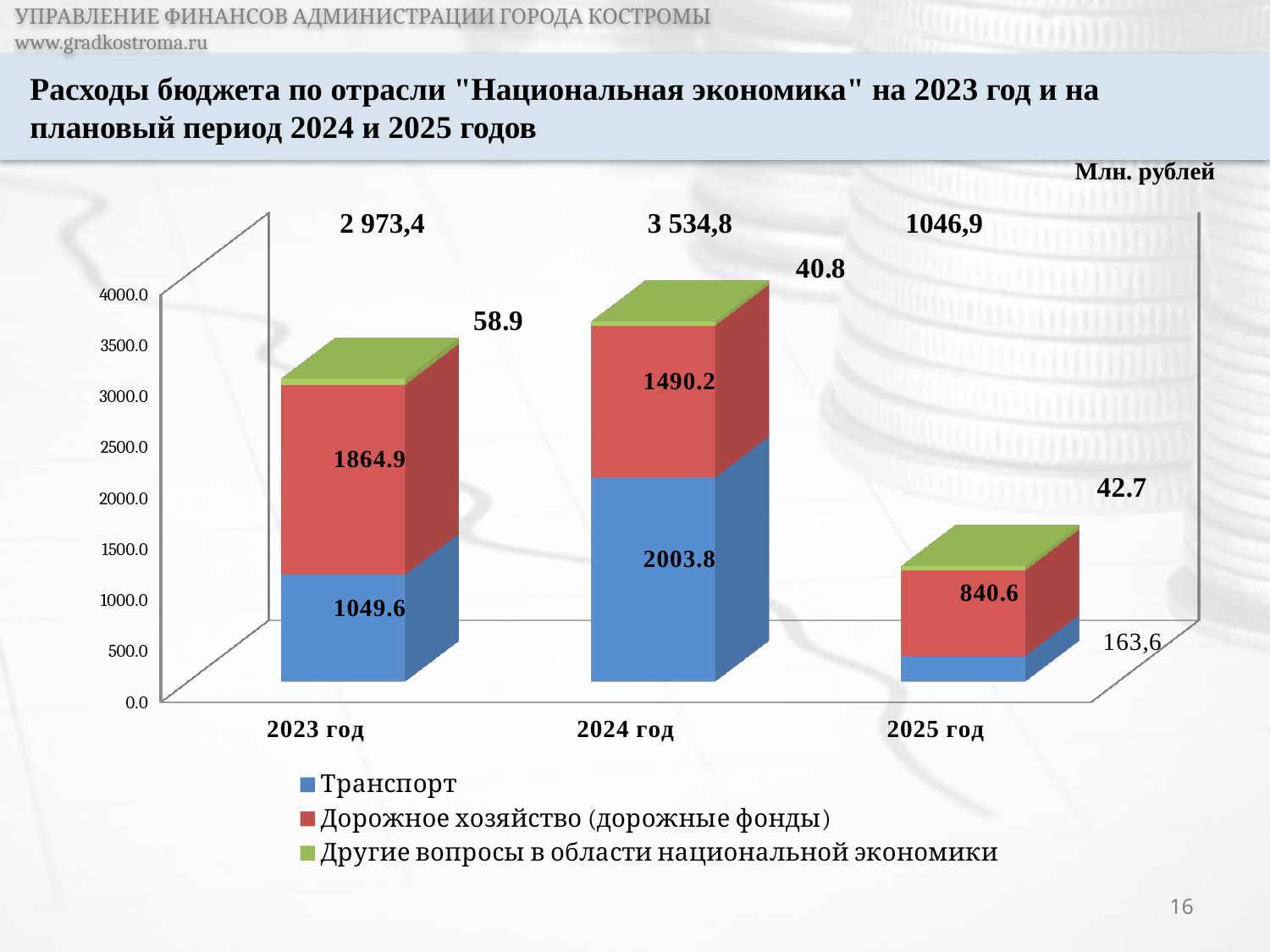
What is the total shown above the bar for 2025 год? 1046,9 What is the difference between the Транспорт values for 2024 год and 2023 год? 954.2 What is the value for Транспорт in 2023 год? 1049.6 What is the total shown above the bar for 2024 год? 3 534,8 What kind of chart is shown on the slide? Stacked bar chart Which year has the highest total? 2024 год How many series does the legend list? 3 Which is larger: Дорожное хозяйство (дорожные фонды) in 2023 год or in 2024 год? 2023 год What is the value for Дорожное хозяйство (дорожные фонды) in 2024 год? 1490.2 What is the value for Другие вопросы в области национальной экономики in 2025 год? 42.7 How many years are shown on the x axis? 3 Which year has the lowest value for Транспорт? 2025 год